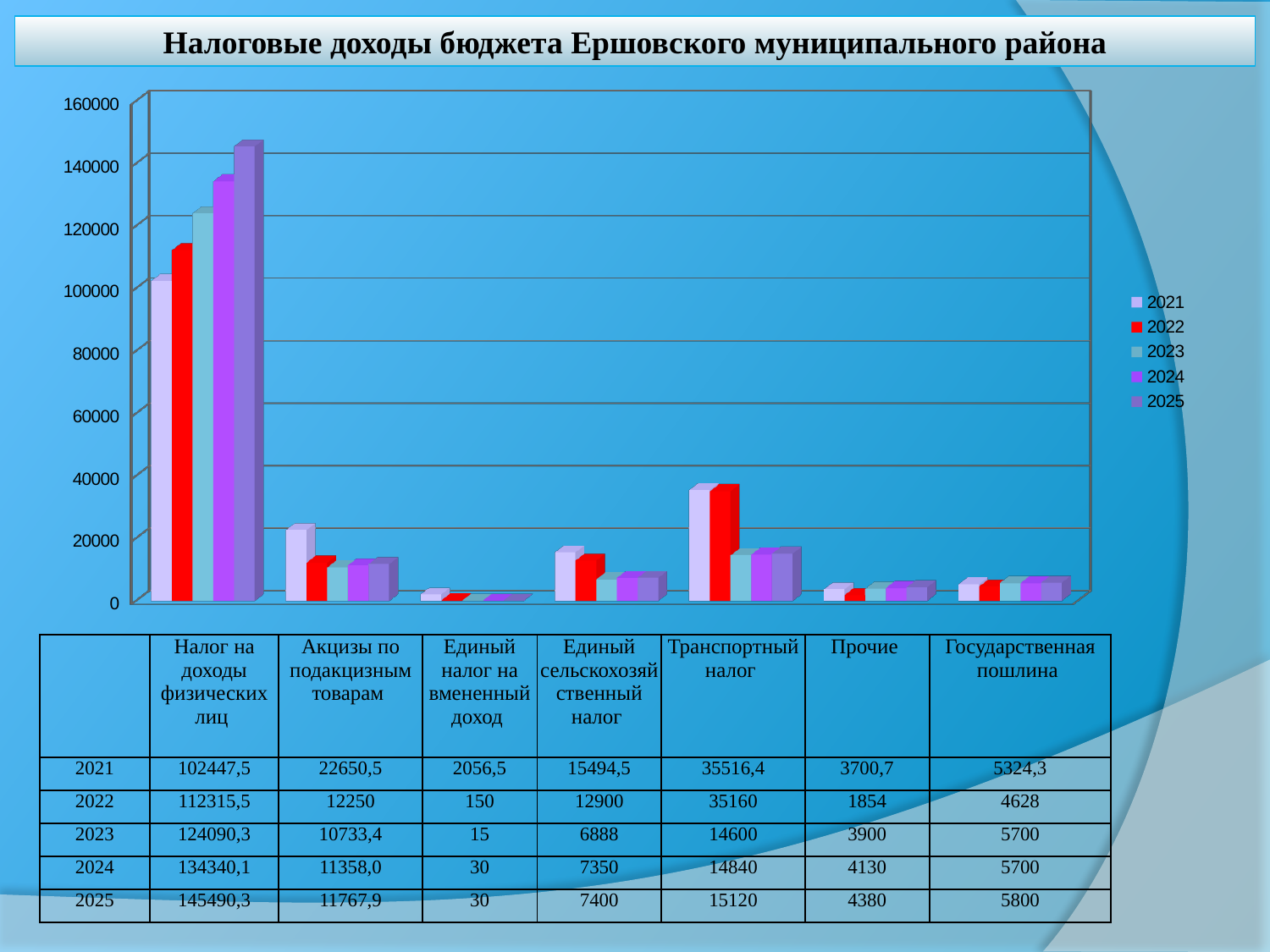
Is the value for Налог на доходы физических лиц in 2021 greater or less than 100000? greater What is the value of Единый налог на вмененный доход for 2023? 15 What kind of chart is shown on the slide? bar chart How many series does the chart legend list? 5 Which year has the larger value for Транспортный налог, 2022 or 2023? 2022 What is the title of the chart? Налоговые доходы бюджета Ершовского муниципального района How many tax categories are plotted on the chart? 7 Do the values for Налог на доходы физических лиц rise or fall from 2021 to 2025? rise What is the value of Транспортный налог for 2021? 35516,4 What is the value of Налог на доходы физических лиц for 2025? 145490,3 Which year has the highest value for Налог на доходы физических лиц? 2025 What is the difference between the 2021 and 2022 values for Акцизы по подакцизным товарам? 10400,5